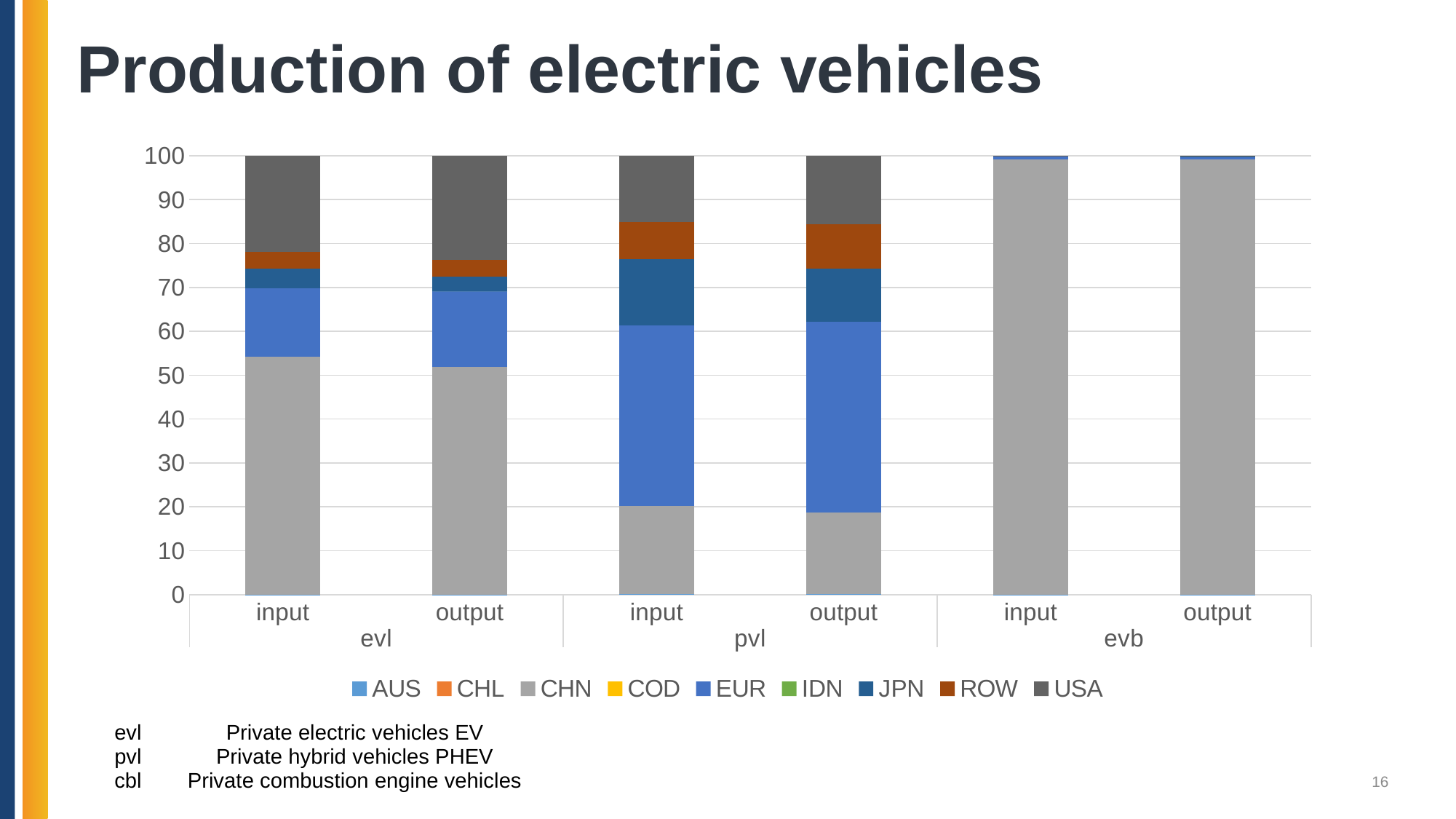
How many bars are plotted in the chart? 6 Which bar has the larger CHN share: evl input or pvl input? evl input Is the CHN share of the evb input bar greater or less than 90? greater How many vehicle-type groups (evl, pvl, evb) are shown on the x axis? 3 Is the CHN share of the pvl input bar greater or less than 30? less How many series does the legend list? 9 What is the total height of the stacked bar for evb input? 100 Which bar has the larger EUR share: evl output or pvl output? pvl output What kind of chart is shown on the slide? stacked bar chart What is the title of the chart on the slide? Production of electric vehicles Which series is shown in grey in the legend? CHN Is the CHN share of the evl input bar greater or less than 50? greater